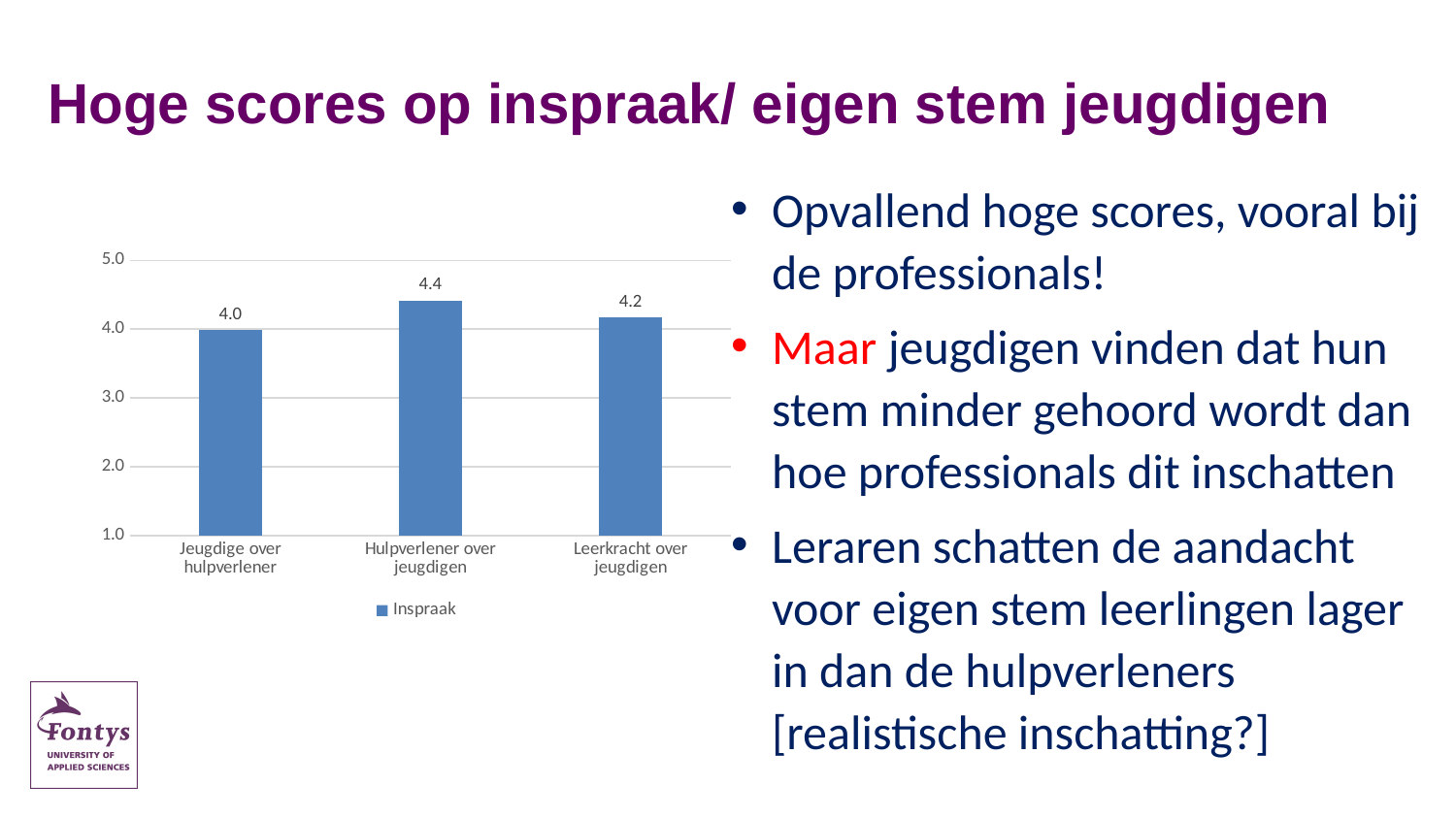
Is the value for "Hulpverlener over jeugdigen" greater or less than 4.0? greater What is the difference between the values for "Hulpverlener over jeugdigen" and "Leerkracht over jeugdigen"? 0.2 Which is larger: the value for "Leerkracht over jeugdigen" or "Jeugdige over hulpverlener"? Leerkracht over jeugdigen How many categories are shown on the x axis? 3 What is the value for "Jeugdige over hulpverlener"? 4.0 What is the value for "Hulpverlener over jeugdigen"? 4.4 Which category has the lowest value? Jeugdige over hulpverlener How many series does the legend list? 1 What kind of chart is shown on the slide? bar chart Which category has the highest value? Hulpverlener over jeugdigen What is the value for "Leerkracht over jeugdigen"? 4.2 What is the difference between the values for "Hulpverlener over jeugdigen" and "Jeugdige over hulpverlener"? 0.4